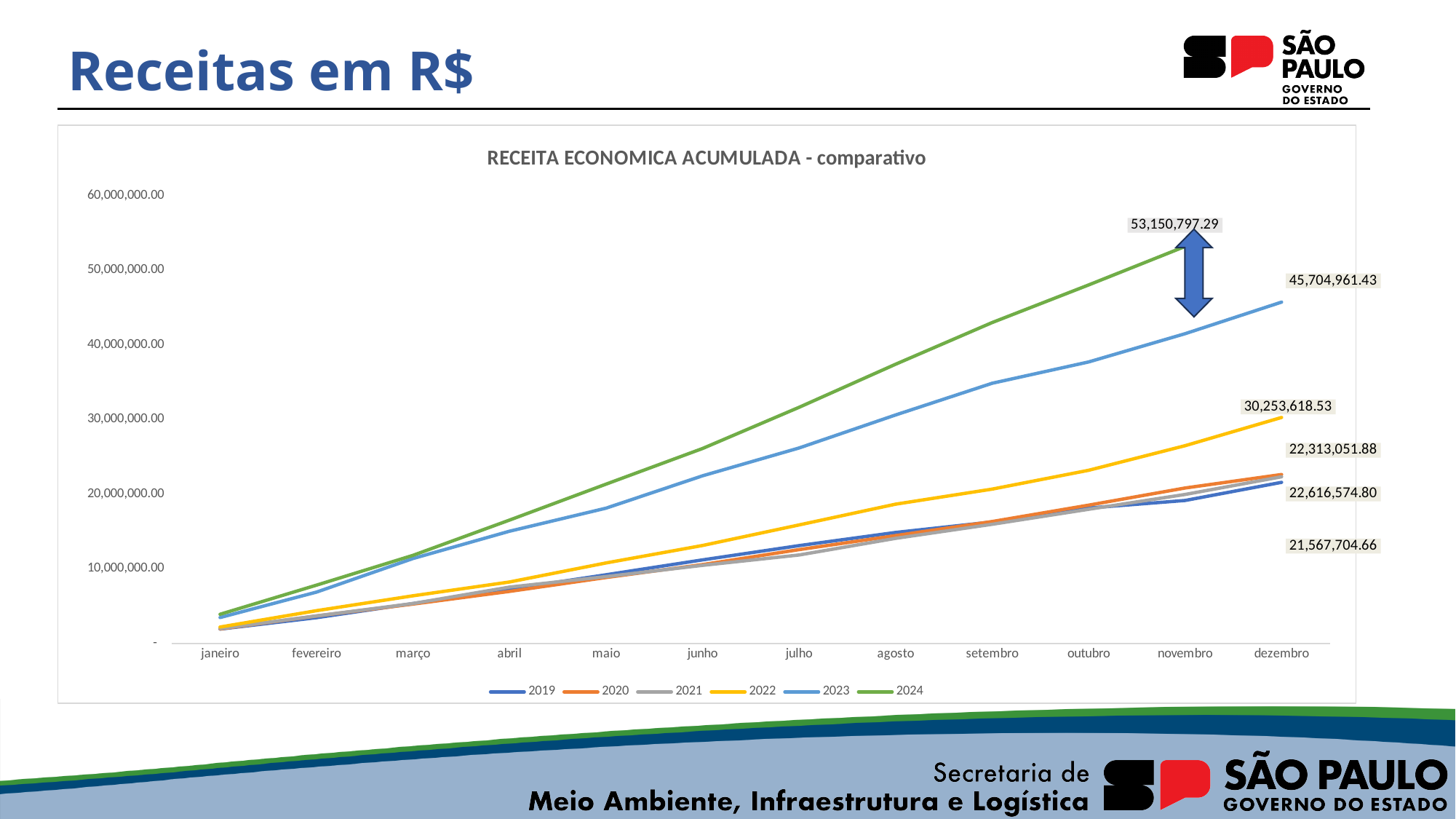
What is the title of the chart? RECEITA ECONOMICA ACUMULADA - comparativo How many series does the legend list? 6 Which series reaches the highest value on the chart? 2024 What is the value labelled for 2022 at dezembro? 30,253,618.53 What is the value labelled at the end of the 2024 line? 53,150,797.29 Is the value for 2023 at junho greater or less than 20,000,000.00? greater What is the value labelled for 2023 at dezembro? 45,704,961.43 How many months are shown along the x axis? 12 What is the difference between the labelled end value of 2024 (53,150,797.29) and the 2023 dezembro value (45,704,961.43)? 7,445,835.86 Which is larger at dezembro, the 2023 value or the 2022 value? 2023 Do the values of the 2024 series rise or fall from janeiro to novembro? rise What kind of chart is shown on the slide? line chart